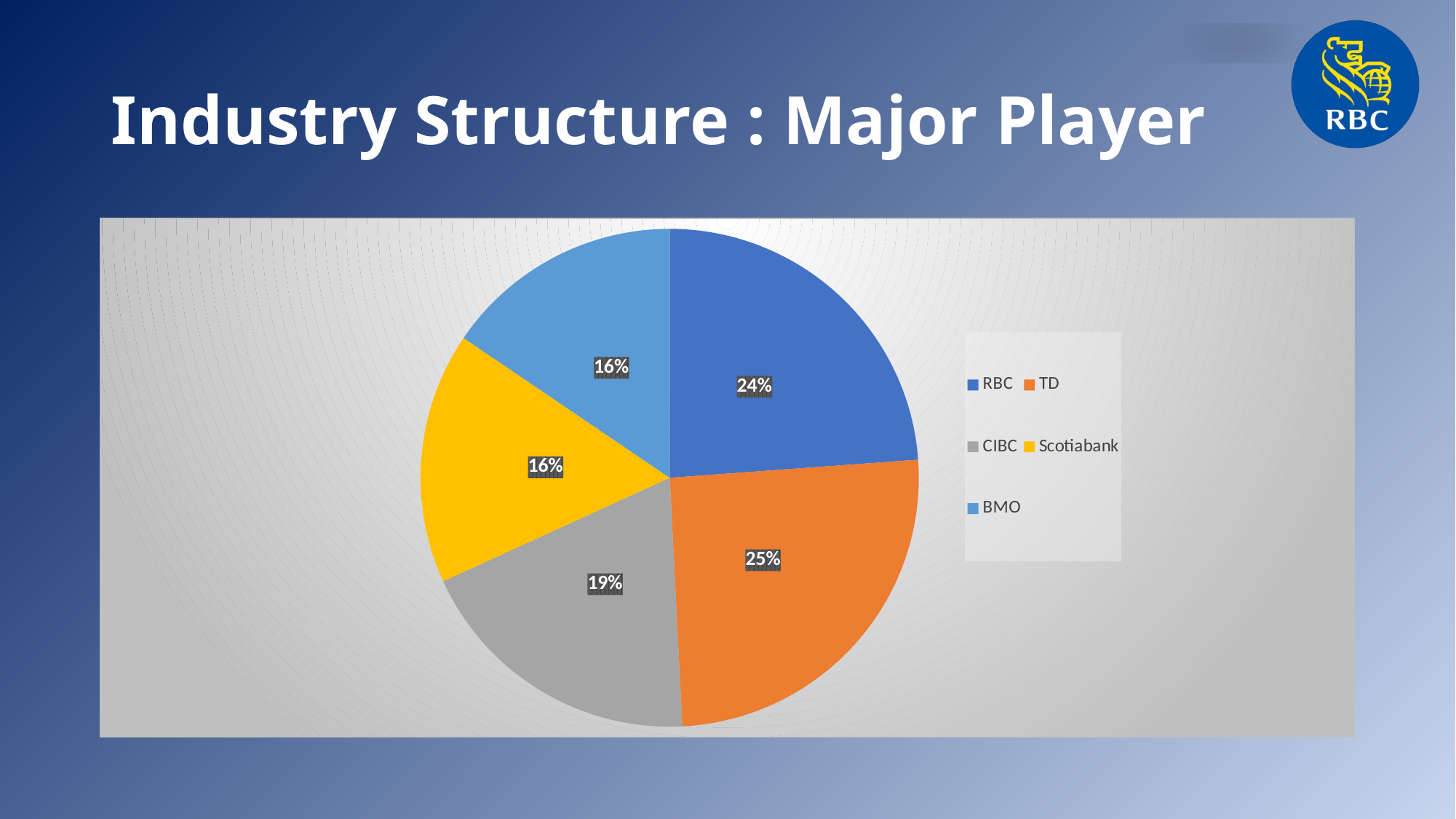
What is the difference in percentage points between TD's share and CIBC's share? 6 What share of the pie does TD hold? 25% What share of the pie does RBC hold? 24% What share of the pie does BMO hold? 16% What share of the pie does CIBC hold? 19% Which is larger, the slice for RBC or the slice for CIBC? RBC How many slices does the pie chart have? 5 What kind of chart is shown on the slide? pie chart How many entries does the legend list? 5 Which bank is represented by the orange slice? TD Which bank has the largest slice of the pie? TD What share of the pie does Scotiabank hold? 16%